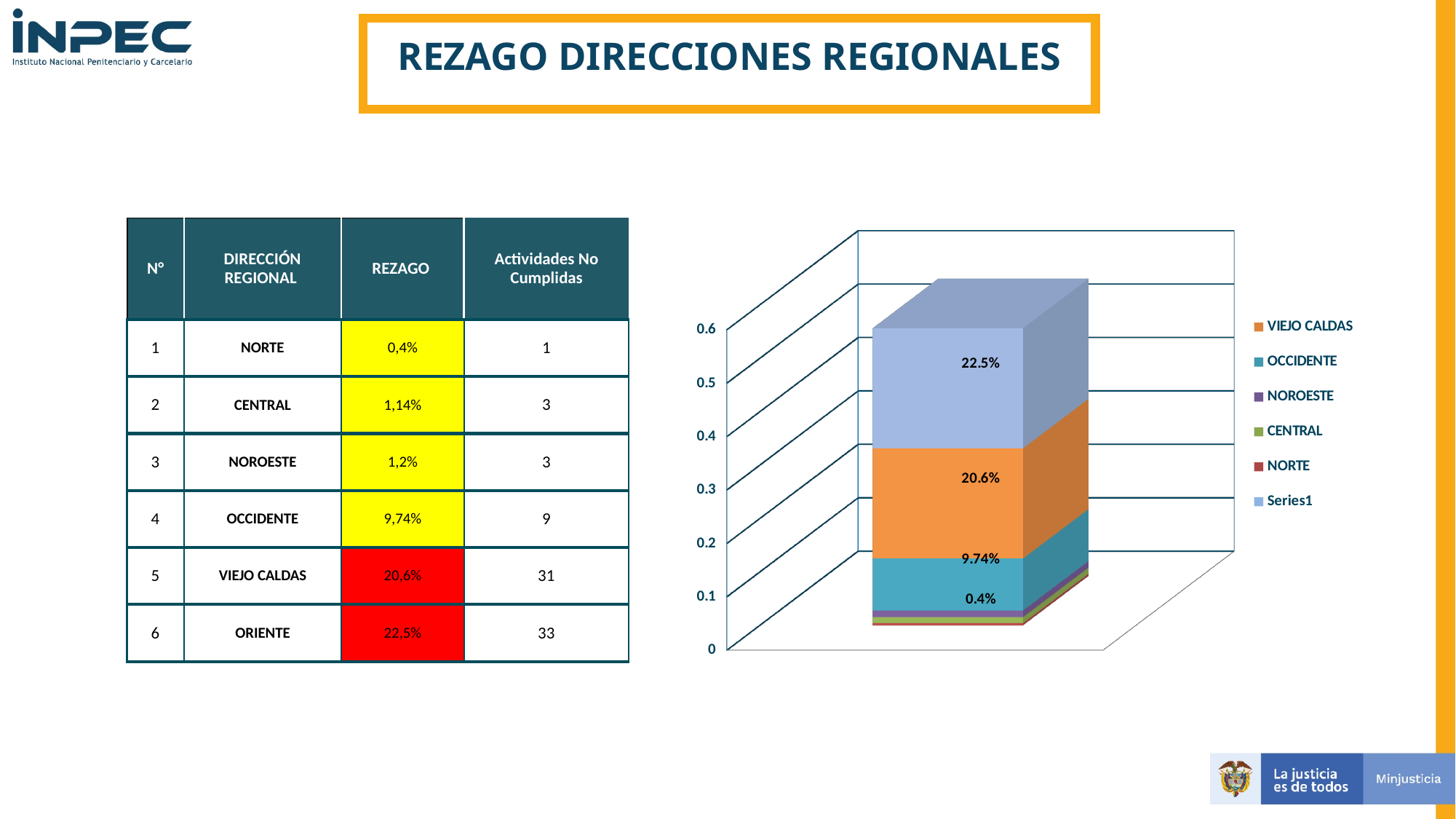
What value is labelled for the OCCIDENTE segment in the chart? 9.74% What kind of chart is shown on the slide? bar chart How many stacked bars are plotted in the chart? 1 What is the highest value shown on the chart's vertical axis? 0.6 What value is labelled for the NORTE segment in the chart? 0.4% Which labelled segment of the stacked bar has the largest value? Series1 What value is labelled for the Series1 segment at the top of the stacked bar? 22.5% What colour is the VIEJO CALDAS entry in the chart's legend? orange What is the difference between the Series1 segment (22.5%) and the VIEJO CALDAS segment (20.6%)? 1.9% What value is labelled for the VIEJO CALDAS segment in the chart? 20.6% How many entries does the chart's legend list? 6 Which is larger in the chart, the VIEJO CALDAS segment or the OCCIDENTE segment? VIEJO CALDAS